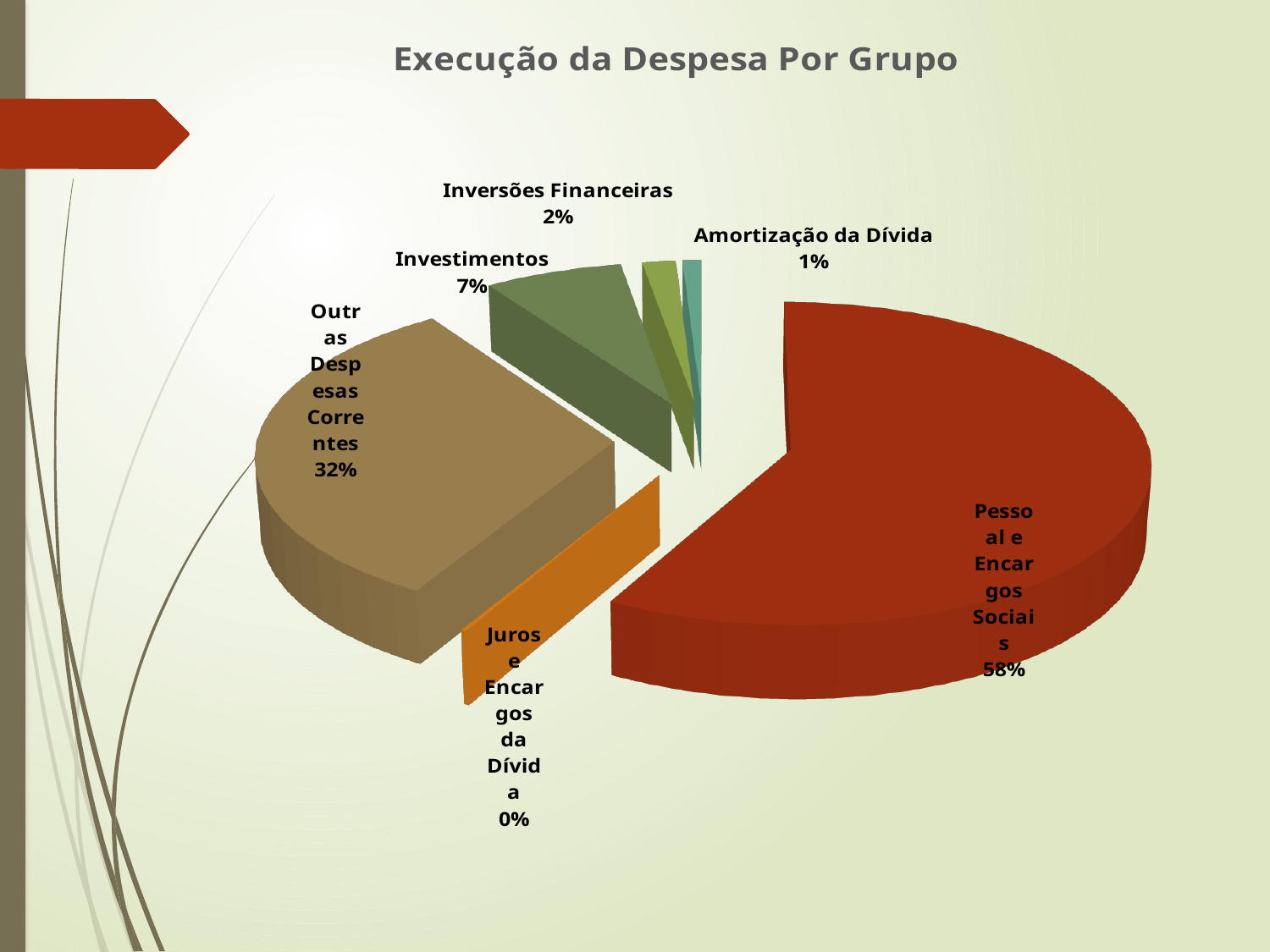
What is the value shown for Juros e Encargos da Dívida? 0% What share of the pie does Outras Despesas Correntes represent? 32% Which category has the smallest slice of the pie? Juros e Encargos da Dívida What share of the pie does Pessoal e Encargos Sociais represent? 58% How many categories are shown in the pie chart? 6 What is the value shown for Amortização da Dívida? 1% What is the title of the chart? Execução da Despesa Por Grupo What is the value shown for Inversões Financeiras? 2% What kind of chart is shown on the slide? Pie chart What is the value shown for Investimentos? 7% What is the difference between the shares of Pessoal e Encargos Sociais and Outras Despesas Correntes? 26% Which category has the largest slice of the pie? Pessoal e Encargos Sociais